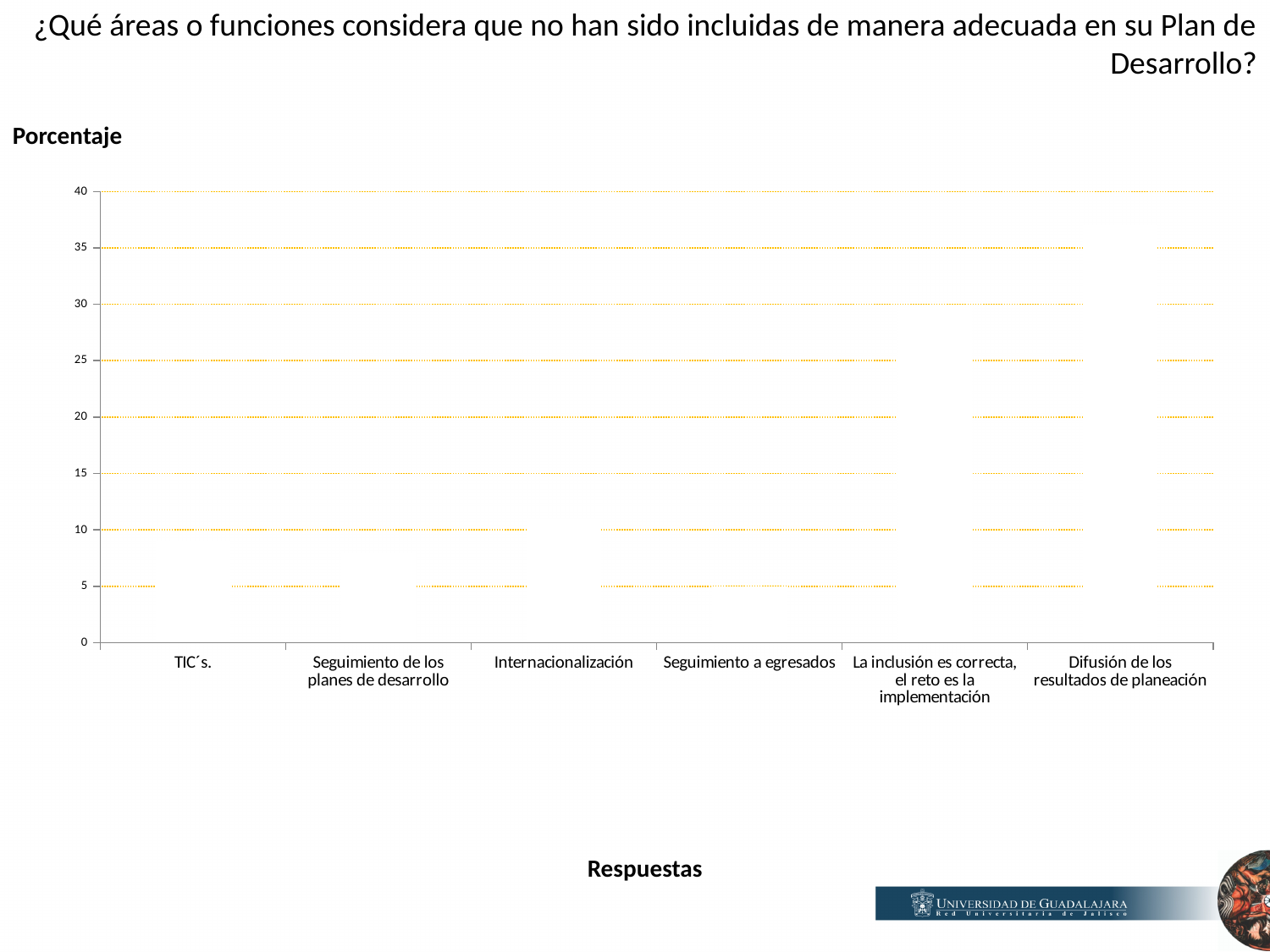
Which category has the highest value? Difusión de los resultados de planeación How many response categories are shown on the x axis? 6 Is the value for TIC´s. greater or less than 10? less What is the label of the horizontal axis? Respuestas Is the value for La inclusión es correcta, el reto es la implementación greater or less than 20? greater Is the value for Difusión de los resultados de planeación greater or less than 30? greater What is the label of the vertical axis? Porcentaje Which is larger, the value for Difusión de los resultados de planeación or the value for TIC´s.? Difusión de los resultados de planeación What kind of chart is shown on the slide? bar chart